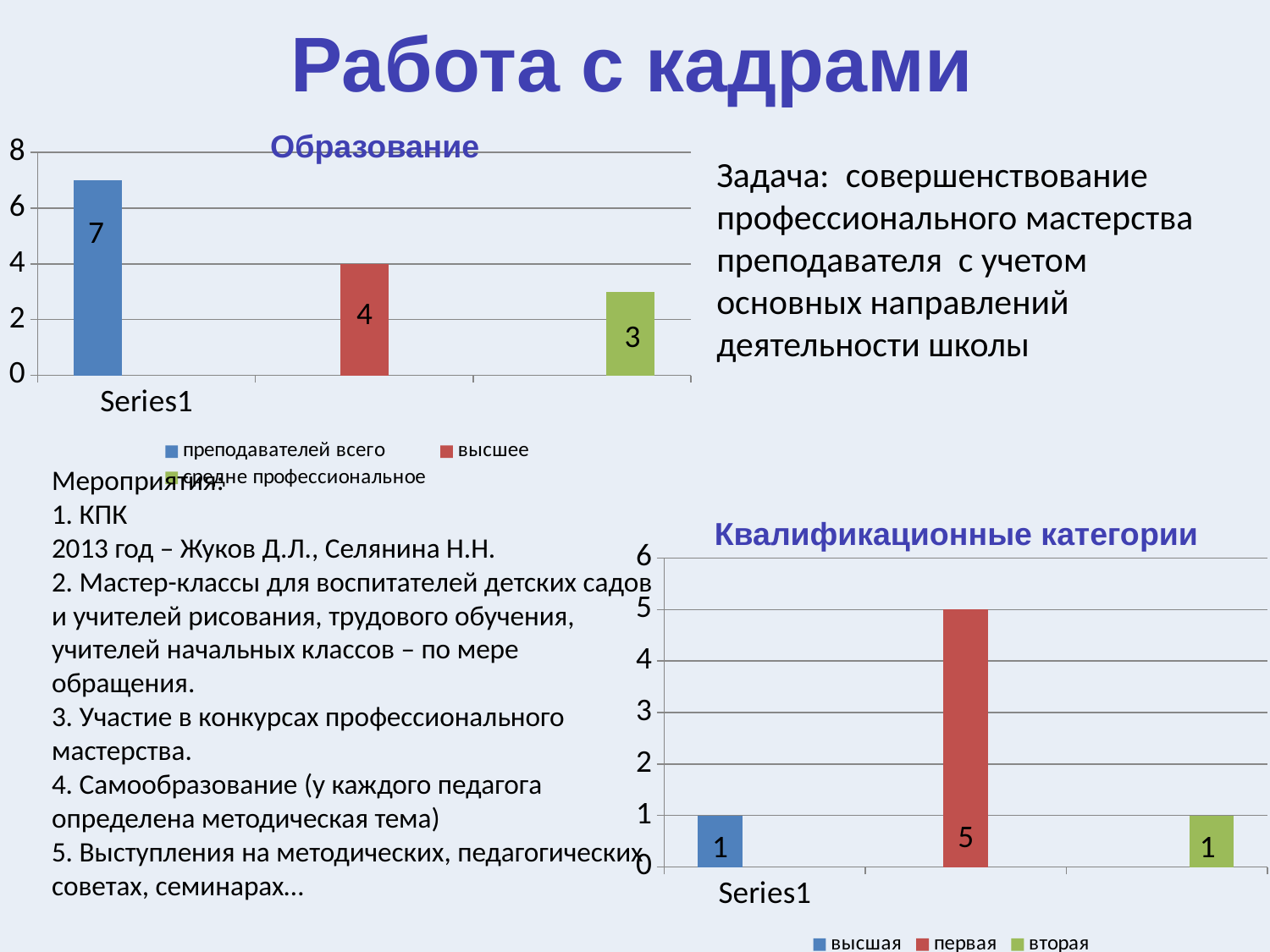
In the 'Образование' chart, what is the difference between 'высшее' and 'средне профессиональное'? 1 In the 'Образование' chart, what is the value for 'преподавателей всего'? 7 In the 'Образование' chart, how many series does the legend list? 3 In the 'Квалификационные категории' chart, what colour is the bar for 'первая'? red In the 'Образование' chart, which series has the highest value? преподавателей всего In the 'Квалификационные категории' chart, what is the value for 'высшая'? 1 In the 'Образование' chart, what is the value for 'высшее'? 4 In the 'Квалификационные категории' chart, which series has the highest value? первая In the 'Квалификационные категории' chart, what is the difference between 'первая' and 'вторая'? 4 What kind of chart is 'Квалификационные категории'? bar chart In the 'Образование' chart, what is the value for 'средне профессиональное'? 3 In the 'Квалификационные категории' chart, what is the value for 'первая'? 5